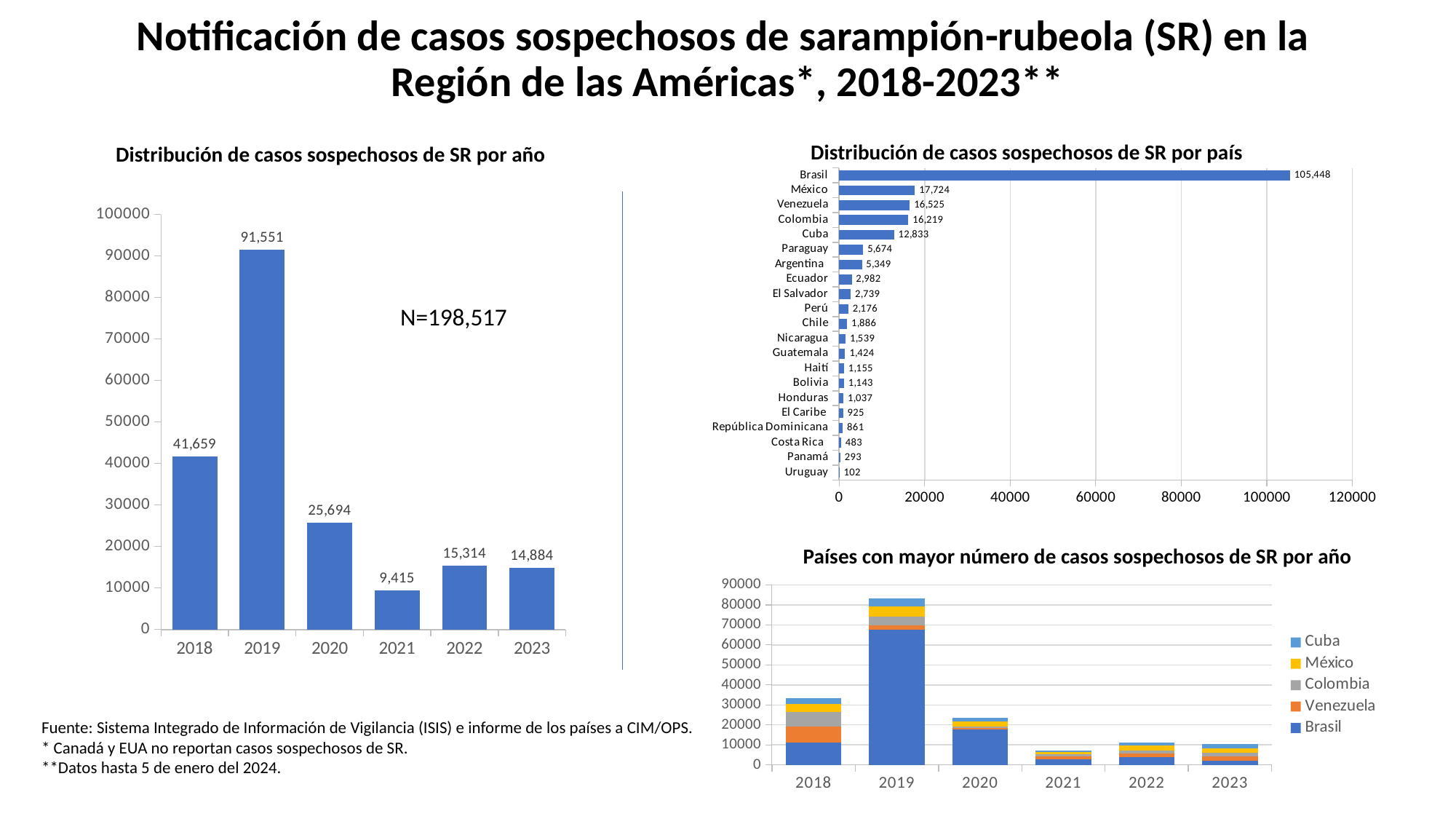
In the chart 'Distribución de casos sospechosos de SR por año', how many years are shown on the x axis? 6 In the chart 'Distribución de casos sospechosos de SR por año', what is the difference between the values for 2018 and 2020? 15,965 In the chart 'Distribución de casos sospechosos de SR por país', which country has the lowest value? Uruguay In the chart 'Distribución de casos sospechosos de SR por país', what is the difference between the values for México and Venezuela? 1,199 In the chart 'Distribución de casos sospechosos de SR por país', how many countries or territories are listed? 21 In the chart 'Países con mayor número de casos sospechosos de SR por año', how many series does the legend list? 5 In the chart 'Distribución de casos sospechosos de SR por país', which country has the highest value? Brasil In the chart 'Distribución de casos sospechosos de SR por año', what is the value for 2019? 91,551 In the chart 'Distribución de casos sospechosos de SR por año', which is larger, the value for 2022 or the value for 2023? 2022 In the chart 'Distribución de casos sospechosos de SR por país', what is the value for Cuba? 12,833 In the chart 'Países con mayor número de casos sospechosos de SR por año', is the total of the stacked bar for 2019 greater or less than 80000? greater In the chart 'Distribución de casos sospechosos de SR por año', which year has the lowest value? 2021